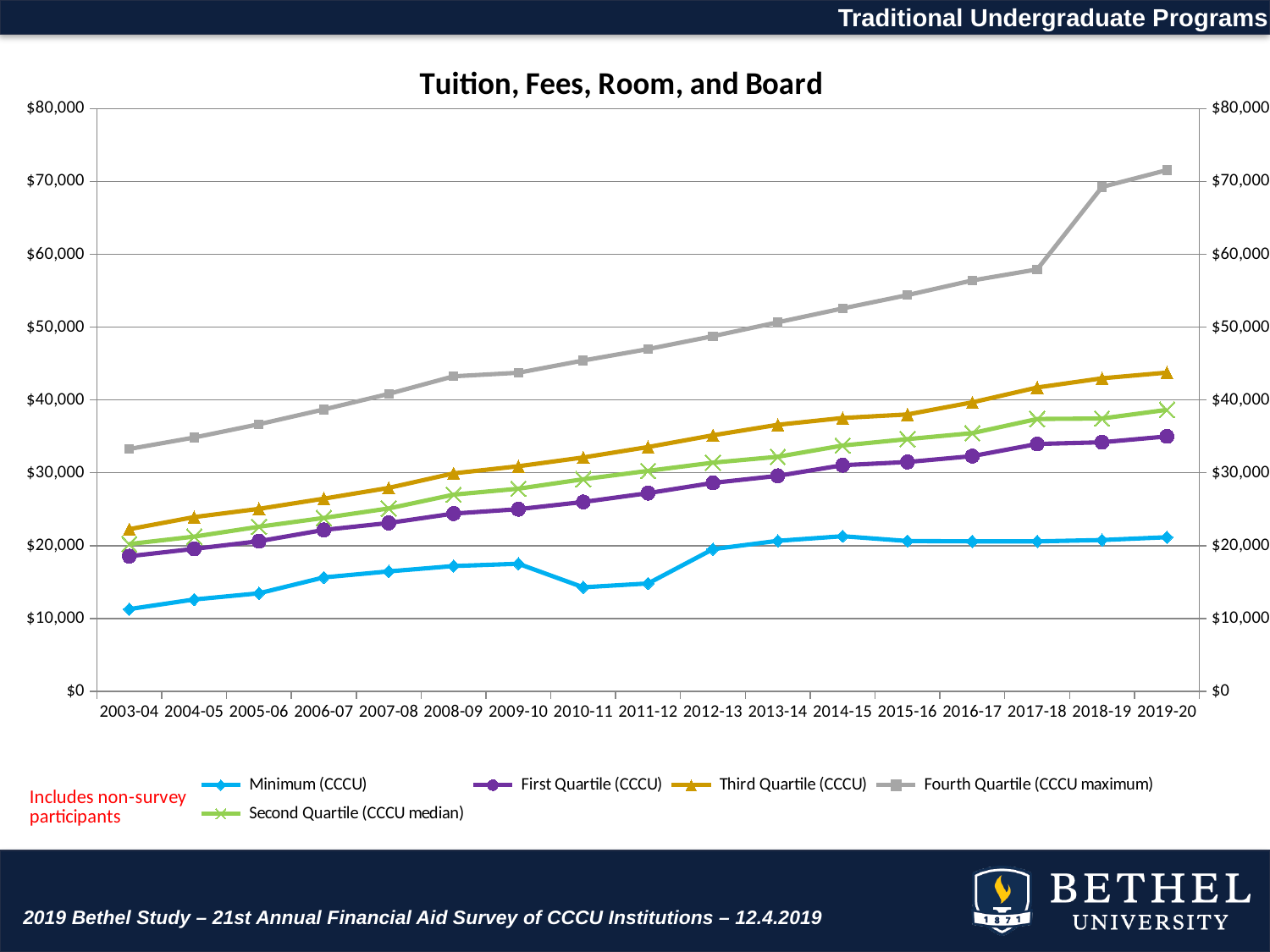
Is the value for First Quartile (CCCU) in 2003-04 greater or less than $20,000? less How many academic years are shown along the x axis? 17 Is the value for Fourth Quartile (CCCU maximum) in 2019-20 greater or less than $70,000? greater Does the Fourth Quartile (CCCU maximum) series generally rise or fall from 2003-04 to 2019-20? rise In which year is the Minimum (CCCU) series at its lowest value? 2003-04 How many series does the legend list? 5 In which year does the Fourth Quartile (CCCU maximum) series reach its highest value? 2019-20 What kind of chart is shown on the slide? line chart Is the value for Third Quartile (CCCU) in 2019-20 greater or less than $40,000? greater What is the title of the chart? Tuition, Fees, Room, and Board